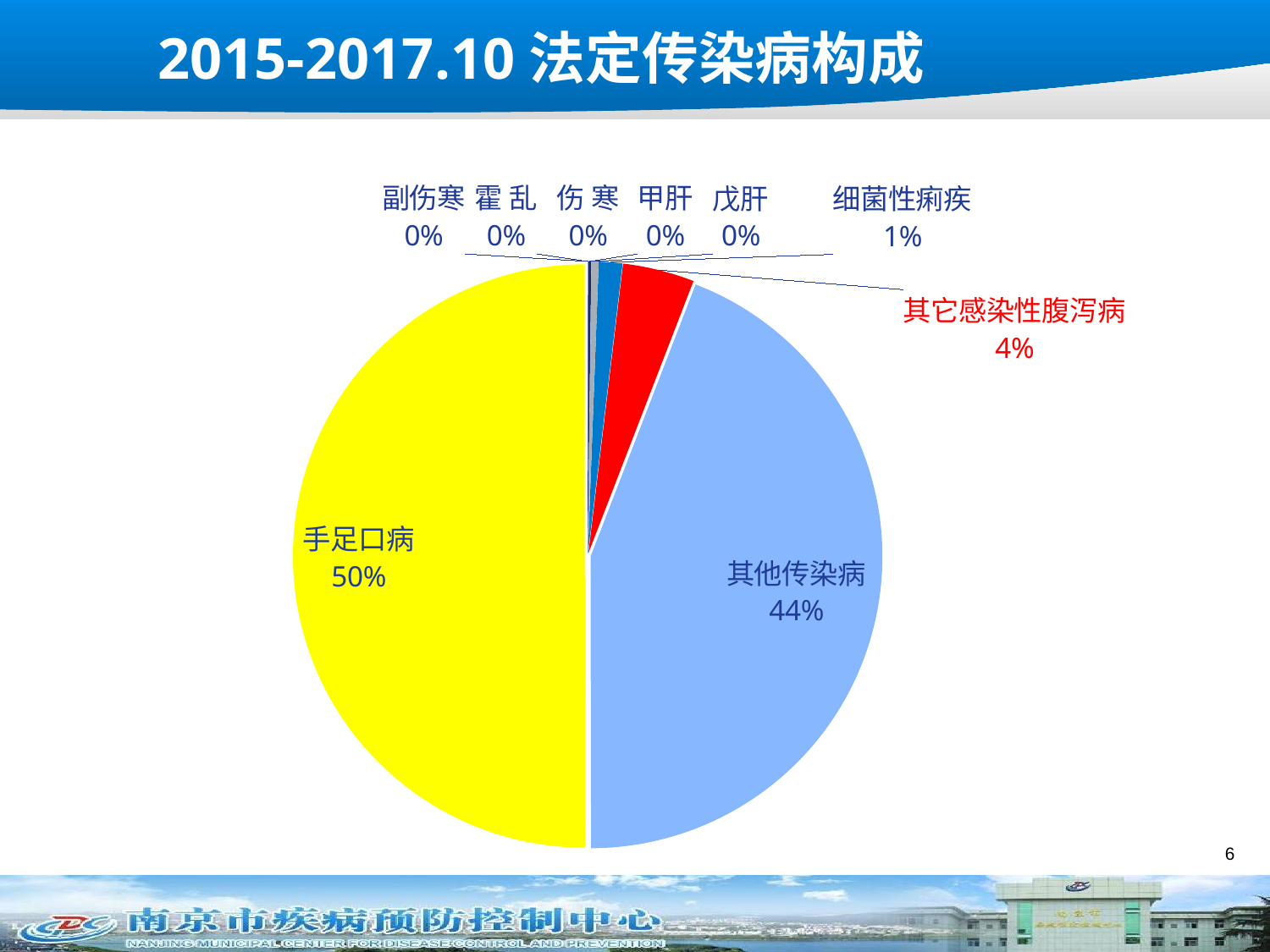
What is the difference between the shares for 其它感染性腹泻病 and 细菌性痢疾? 3% What is the share for 其他传染病? 44% Which category has the largest slice of the pie? 手足口病 What is the difference between the shares for 手足口病 and 其他传染病? 6% What is the share for 手足口病? 50% What is the share for 细菌性痢疾? 1% What is the share for 其它感染性腹泻病? 4% What is the title of the chart on the slide? 2015-2017.10 法定传染病构成 Which is larger, the share for 手足口病 or the share for 其他传染病? 手足口病 How many categories are labelled on the pie chart? 9 What kind of chart is shown on the slide? pie chart What is the share for 甲肝? 0%